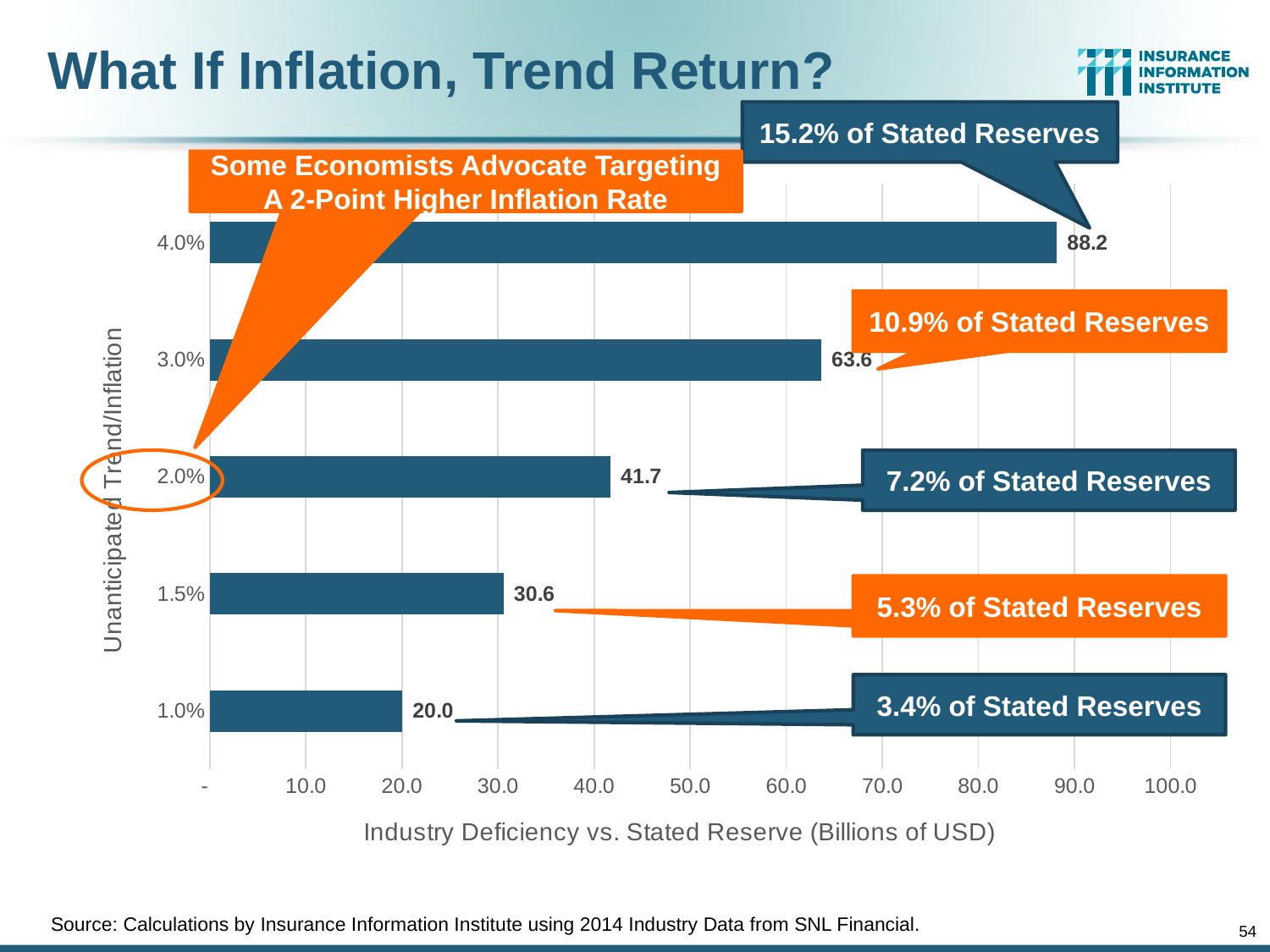
How many inflation levels (bars) are shown in the chart? 5 What is the industry deficiency value for an unanticipated trend/inflation of 1.5%? 30.6 Which unanticipated trend/inflation level has the lowest industry deficiency? 1.0% What type of chart is shown on the slide? bar chart Which is larger, the industry deficiency at 3.0% inflation or at 2.0% inflation? 3.0% Which unanticipated trend/inflation level has the highest industry deficiency? 4.0% What percentage of stated reserves does the callout give for the 4.0% inflation bar? 15.2% of Stated Reserves What is the difference between the industry deficiency at 4.0% and at 3.0% inflation? 24.6 What is the difference between the industry deficiency at 2.0% and at 1.0% inflation? 21.7 Is the industry deficiency at 3.0% inflation greater or less than 60.0? greater What is the industry deficiency value for an unanticipated trend/inflation of 4.0%? 88.2 What is the industry deficiency value for an unanticipated trend/inflation of 2.0%? 41.7